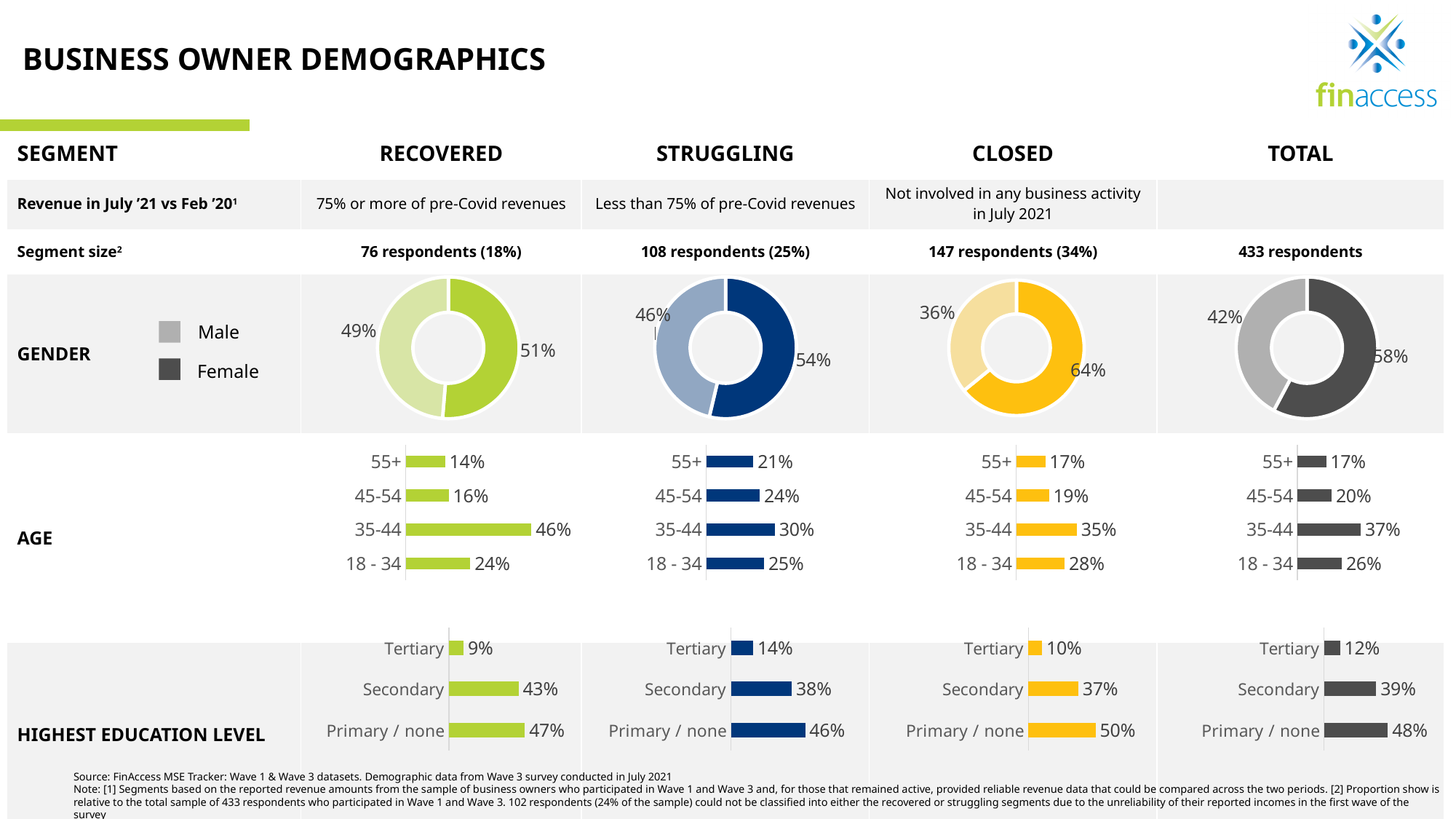
In the Age bar chart for the Struggling segment, which age group has the highest value? 35-44 In the Highest Education Level bar chart for the Closed segment, which category has the highest value? Primary / none In the Age bar chart for the Closed segment, which age group has the lowest value? 55+ In the Gender donut chart for the Recovered segment, what share is Female? 51% In the Highest Education Level bar chart for the Struggling segment, what is the value for Secondary? 38% In the Gender donut chart for the Total column, what share is Female? 58% In the Gender donut chart for the Closed segment, what share is Male? 36% How many categories are shown in the Age bar chart for the Total column? 4 In the Highest Education Level bar chart for the Recovered segment, which is larger: Tertiary or Secondary? Secondary In the Age bar chart for the Total column, what is the difference between the 35-44 value and the 18 - 34 value? 11% What kind of chart is used to show Gender for each segment? Donut (pie) chart In the Age bar chart for the Recovered segment, what is the value for 35-44? 46%